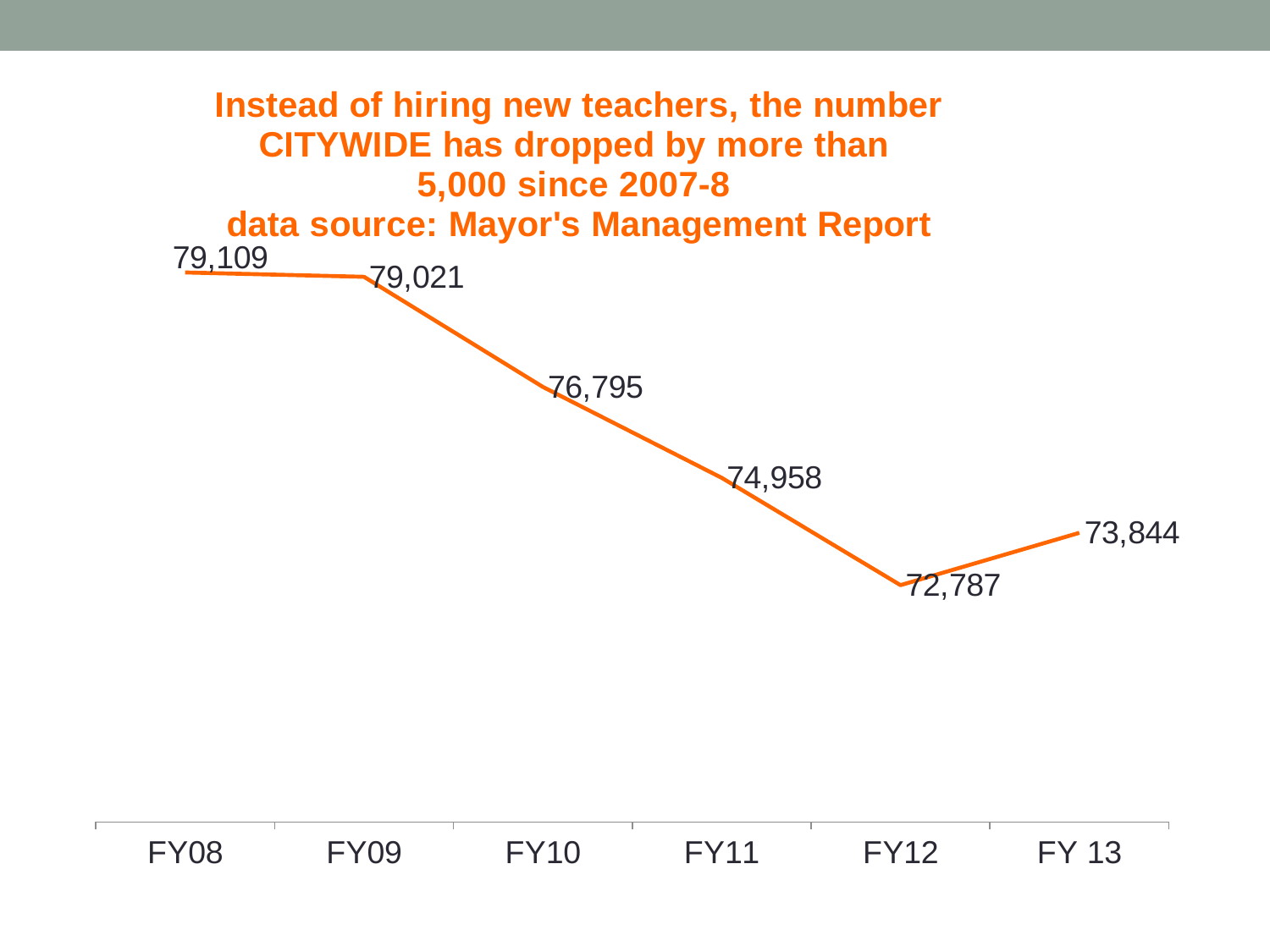
Which is larger, the value for FY11 or the value for FY 13? FY11 Which fiscal year has the highest value? FY08 Do the values generally rise or fall from FY08 to FY12? Fall What kind of chart is shown on the slide? Line chart Which fiscal year has the lowest value? FY12 What is the value for FY10? 76,795 What is the difference between the FY 13 value and the FY12 value? 1,057 What is the difference between the FY08 value and the FY12 value? 6,322 What is the value for FY08? 79,109 What is the value for FY 13? 73,844 What is the value for FY12? 72,787 How many fiscal years are plotted on the chart? 6